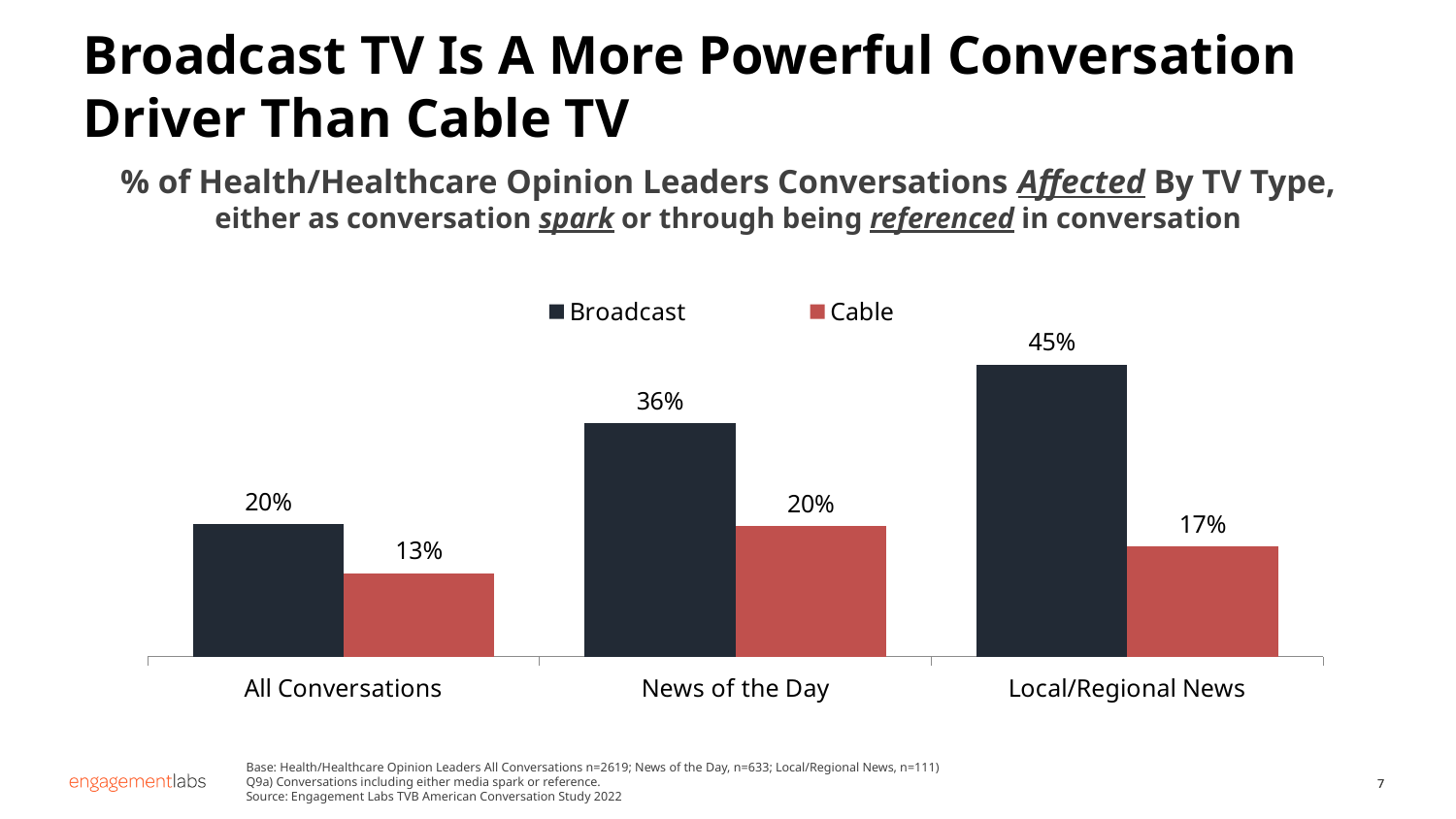
Which category has the lowest Cable value? All Conversations What is the Cable value for News of the Day? 20% How many series does the legend list? 2 How many categories are shown on the x axis? 3 What is the Cable value for All Conversations? 13% Which category has the highest Broadcast value? Local/Regional News What is the Broadcast value for All Conversations? 20% What is the difference between the Broadcast and Cable values for News of the Day? 16% For All Conversations, which is larger: Broadcast or Cable? Broadcast What is the Broadcast value for Local/Regional News? 45% What kind of chart is shown on the slide? Bar chart What is the difference between the Broadcast and Cable values for Local/Regional News? 28%